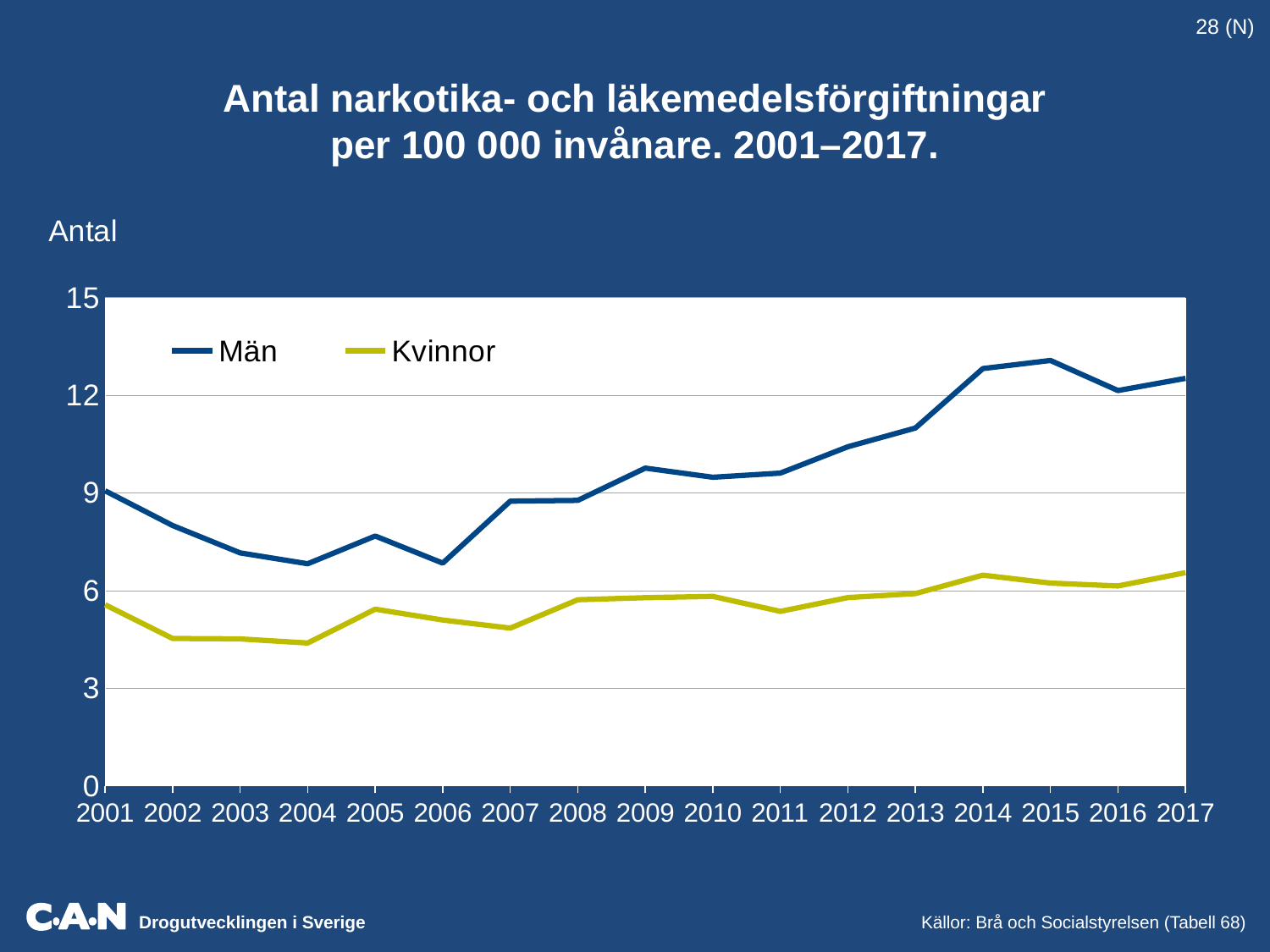
Is the value for Män in 2015 greater or less than 12? greater Is the value for Kvinnor in 2017 greater or less than 6? greater In which year does the Män series reach its highest value? 2015 What kind of chart is shown on the slide? line chart How many series does the legend list? 2 Is the value for Kvinnor in 2004 greater or less than 6? less How many years are plotted along the x axis? 17 Which two series are shown in the legend? Män and Kvinnor Which series has the higher value in 2010, Män or Kvinnor? Män Does the Män series overall rise or fall from 2001 to 2017? rise What is the label on the vertical axis of the chart? Antal